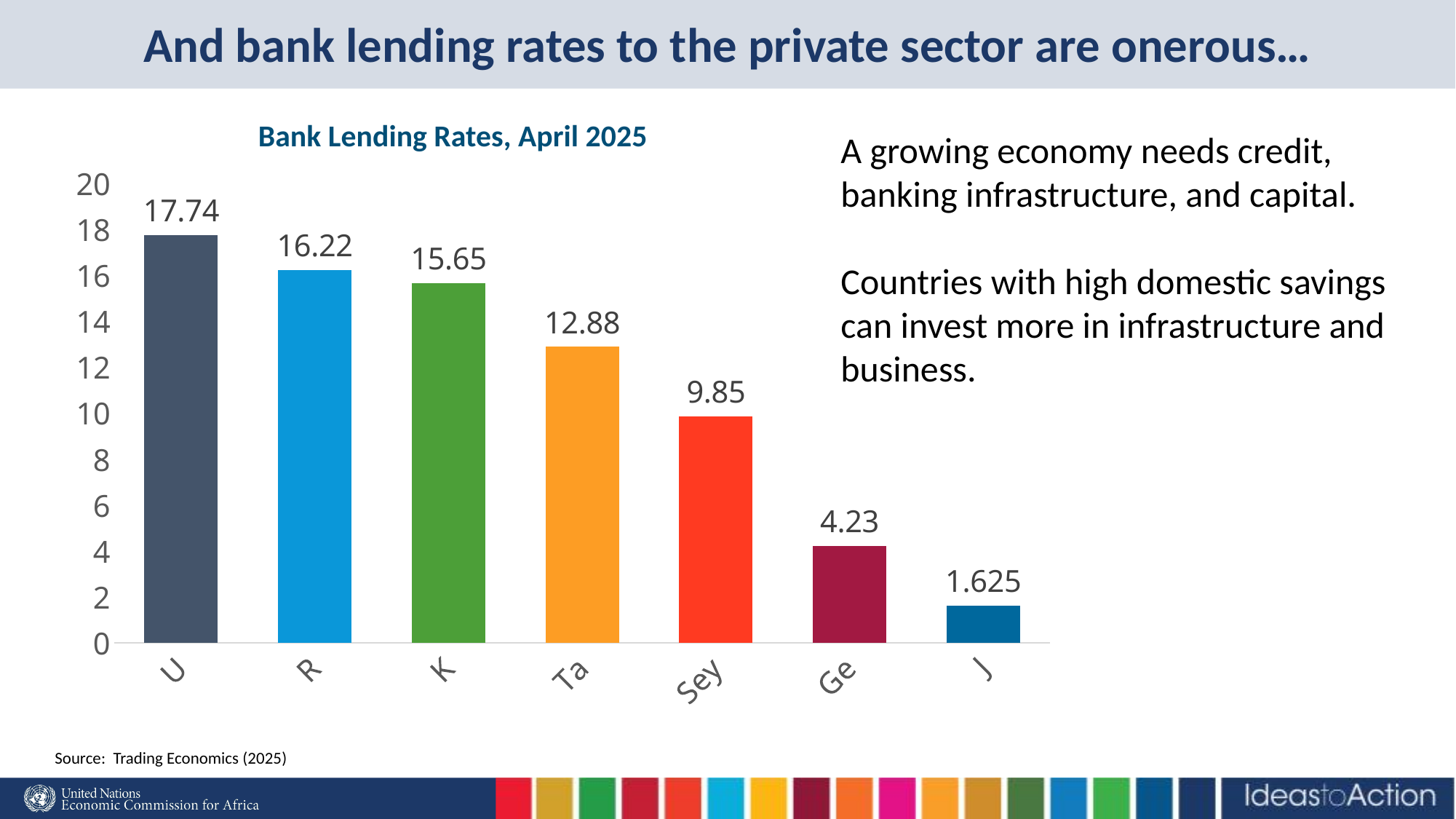
How many categories (bars) are shown in the chart? 7 What is the difference between the values for "Ta" and "Ge"? 8.65 What is the title of the chart? Bank Lending Rates, April 2025 Which is larger, the value for "Ta" or the value for "Sey"? Ta What value is shown for the category labelled "J"? 1.625 Is the value for "Ge" greater or less than 6? less Which category has the highest bank lending rate? U What value is shown for the category labelled "Sey"? 9.85 Which category has the lowest bank lending rate? J What kind of chart is shown on the slide? Bar chart What is the difference between the values for "R" and "K"? 0.57 What is the bank lending rate shown for the category labelled "U"? 17.74